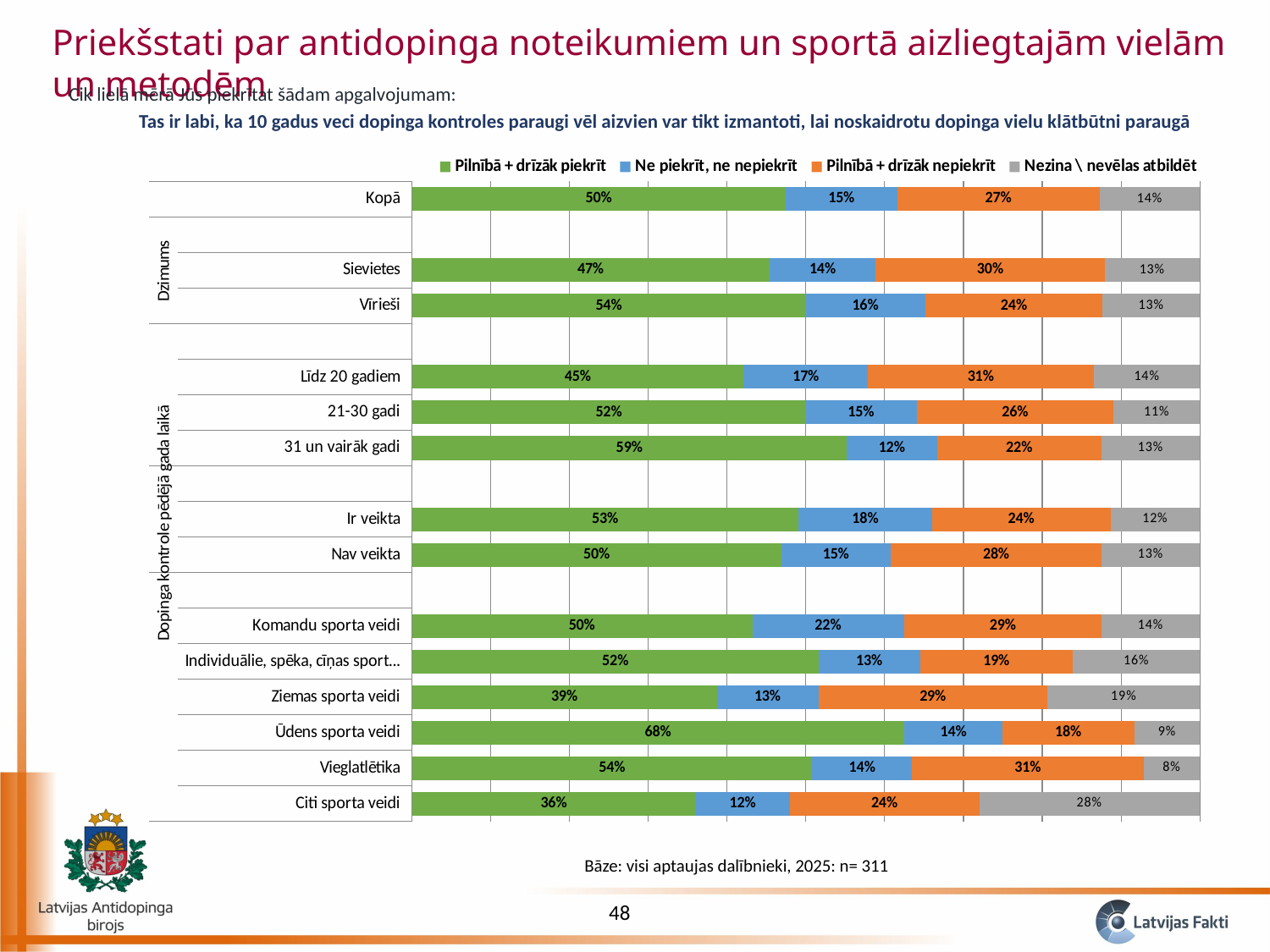
What kind of chart is shown on the slide? Stacked bar chart Which is larger: the "Ne piekrīt, ne nepiekrīt" value for Komandu sporta veidi or for Ziemas sporta veidi? Komandu sporta veidi How many categories (bars) are plotted in the chart? 14 What is the difference between the "Pilnībā + drīzāk piekrīt" values for Vīrieši and Sievietes? 7% What is the value of "Nezina \ nevēlas atbildēt" for Citi sporta veidi? 28% Which category has the lowest value for "Pilnībā + drīzāk piekrīt"? Citi sporta veidi What is the value of "Ne piekrīt, ne nepiekrīt" for 31 un vairāk gadi? 12% What is the value of "Pilnībā + drīzāk piekrīt" for Kopā? 50% Which colour represents the "Pilnībā + drīzāk nepiekrīt" series? Orange How many series does the legend list? 4 Which category has the highest value for "Pilnībā + drīzāk piekrīt"? Ūdens sporta veidi What is the value of "Pilnībā + drīzāk nepiekrīt" for Sievietes? 30%